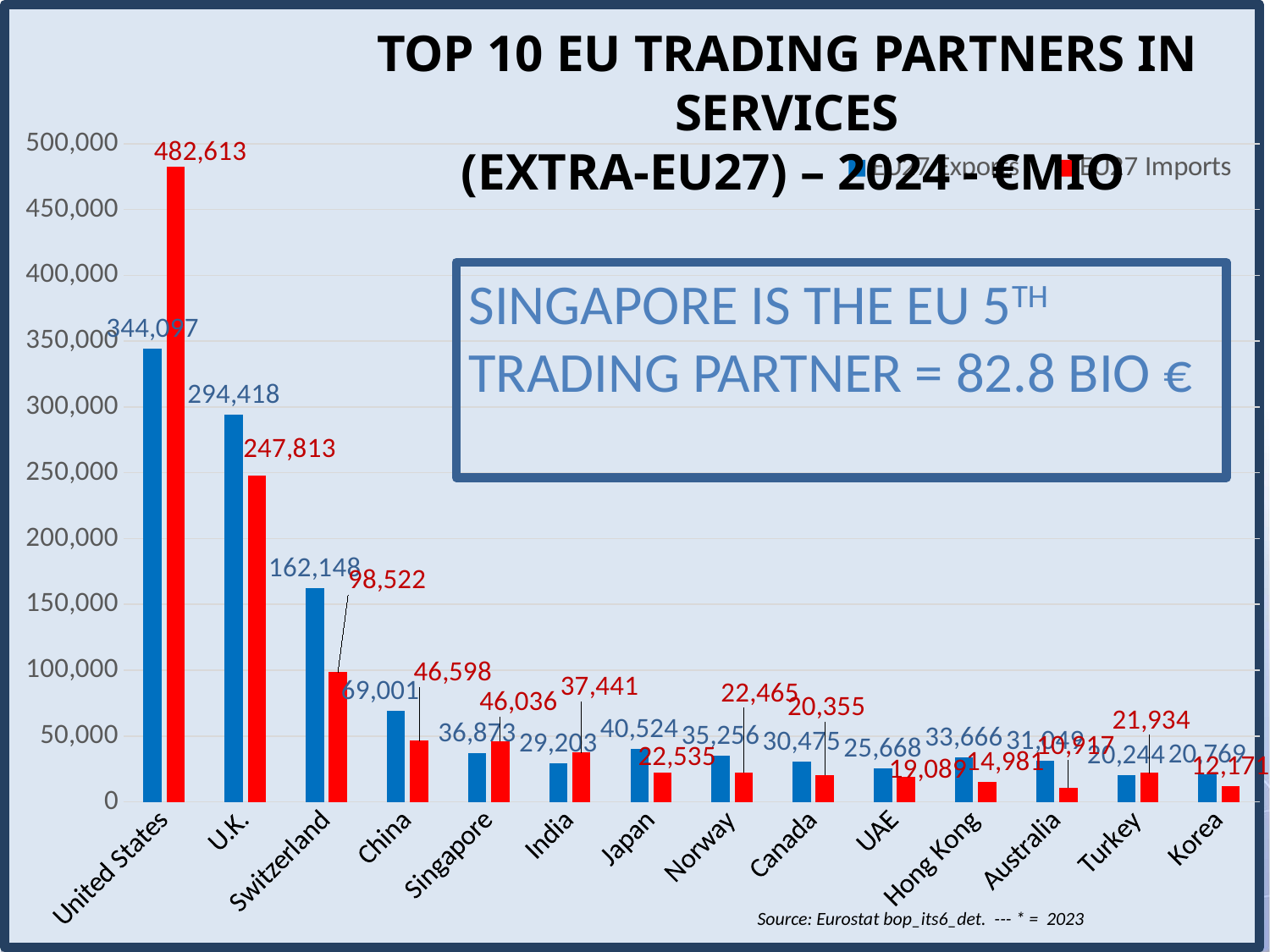
What is the EU27 Imports value for the United States? 482,613 What is the EU27 Imports value for Switzerland? 98,522 What is the EU27 Exports value for the U.K.? 294,418 For Singapore, which is larger: EU27 Exports or EU27 Imports? EU27 Imports What is the difference between EU27 Imports and EU27 Exports for the United States? 138,516 How many trading partners are shown on the x axis? 14 Which trading partner has the highest EU27 Imports value? United States Which trading partner has the lowest EU27 Imports value? Australia How many series does the legend list? 2 What kind of chart is shown on the slide? Bar chart Is the EU27 Exports value for Switzerland greater or less than 150,000? greater What is the EU27 Exports value for China? 69,001